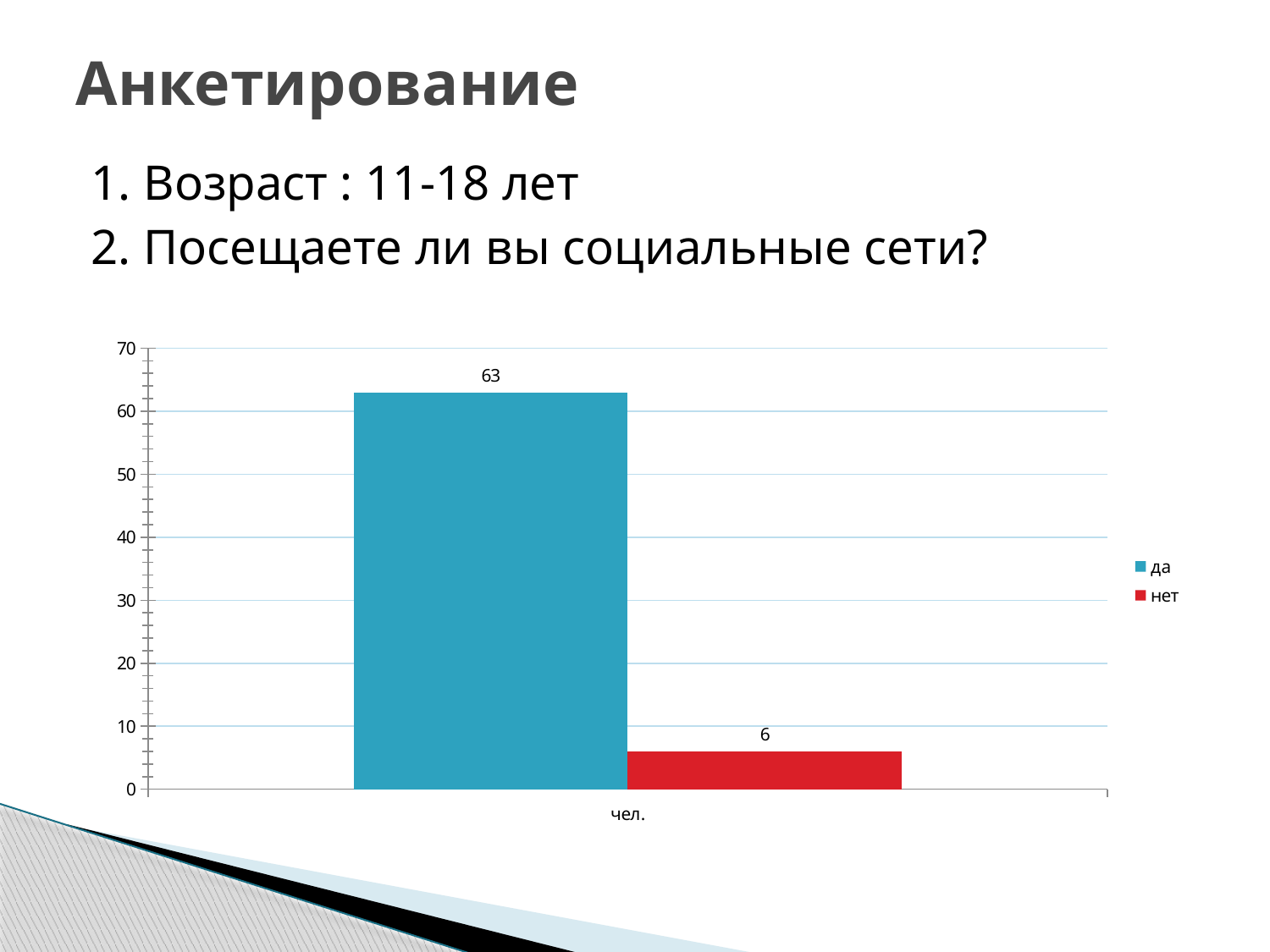
What is the label on the x axis of the chart? чел. What kind of chart is shown on the slide? bar chart Which series has the lowest value in the chart? нет Is the value for "нет" greater or less than 10? less What is the difference between the values for "да" and "нет"? 57 Which is larger, the value for "да" or the value for "нет"? да What is the value for "да" in the chart? 63 What colour is the bar for "нет"? red How many series does the legend list? 2 Which series has the highest value in the chart? да What is the value for "нет" in the chart? 6 Is the value for "да" greater or less than 60? greater